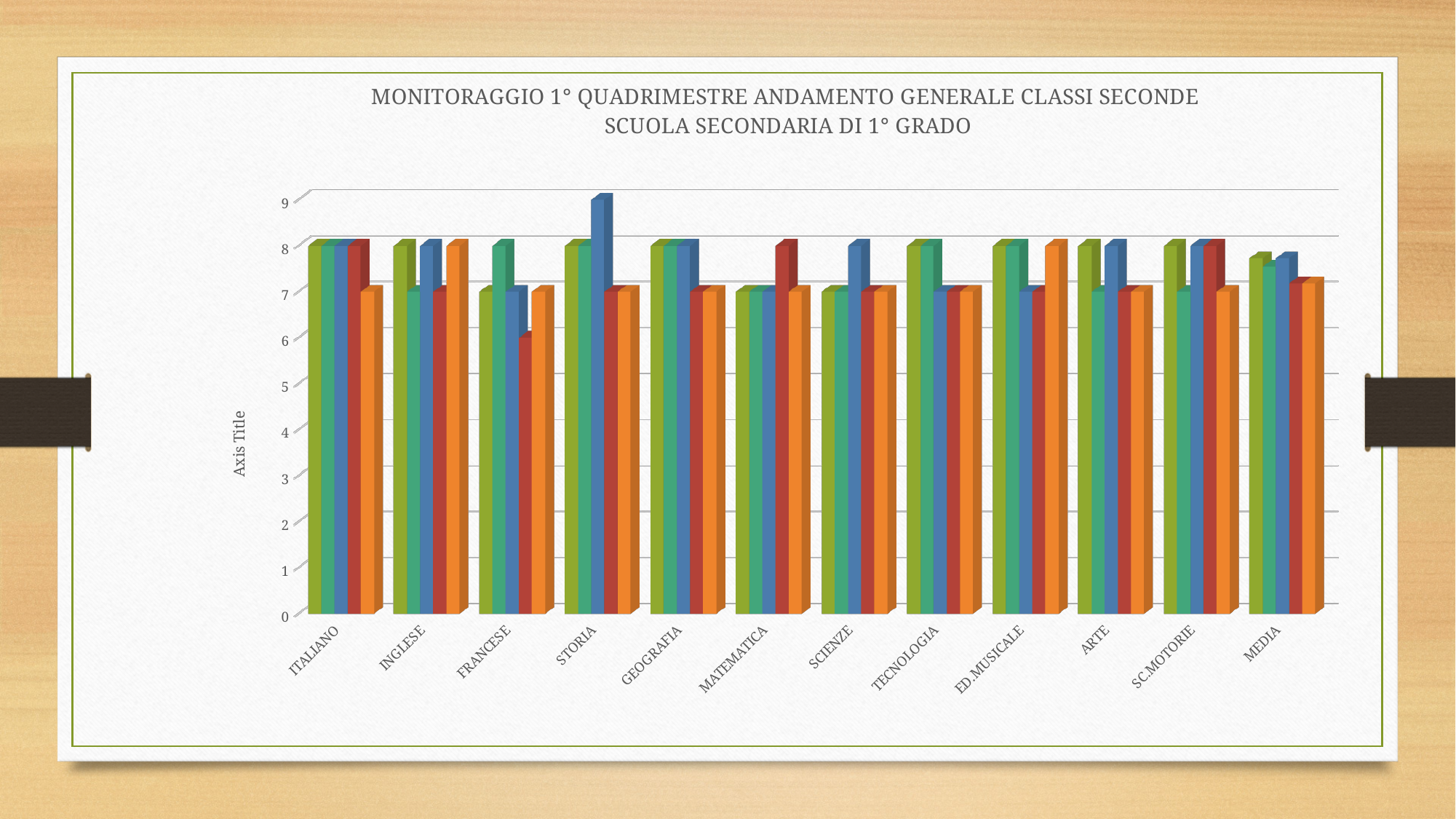
How many bars are plotted for each category? 5 How many subject categories are shown along the x axis? 12 What is the difference between the blue bar for STORIA and the red bar for FRANCESE? 3 Which is larger: the blue bar for STORIA or the red bar for FRANCESE? the blue bar for STORIA What value does the red bar for FRANCESE reach? 6 What value does the blue bar for STORIA reach? 9 What label is shown on the vertical axis? Axis Title Which category contains the tallest bar in the chart? STORIA Which category contains the shortest bar in the chart? FRANCESE What kind of chart is shown on the slide? bar chart What is the title of the chart? MONITORAGGIO 1° QUADRIMESTRE ANDAMENTO GENERALE CLASSI SECONDE SCUOLA SECONDARIA DI 1° GRADO Is the value of the green bar for MEDIA greater or less than 7? greater